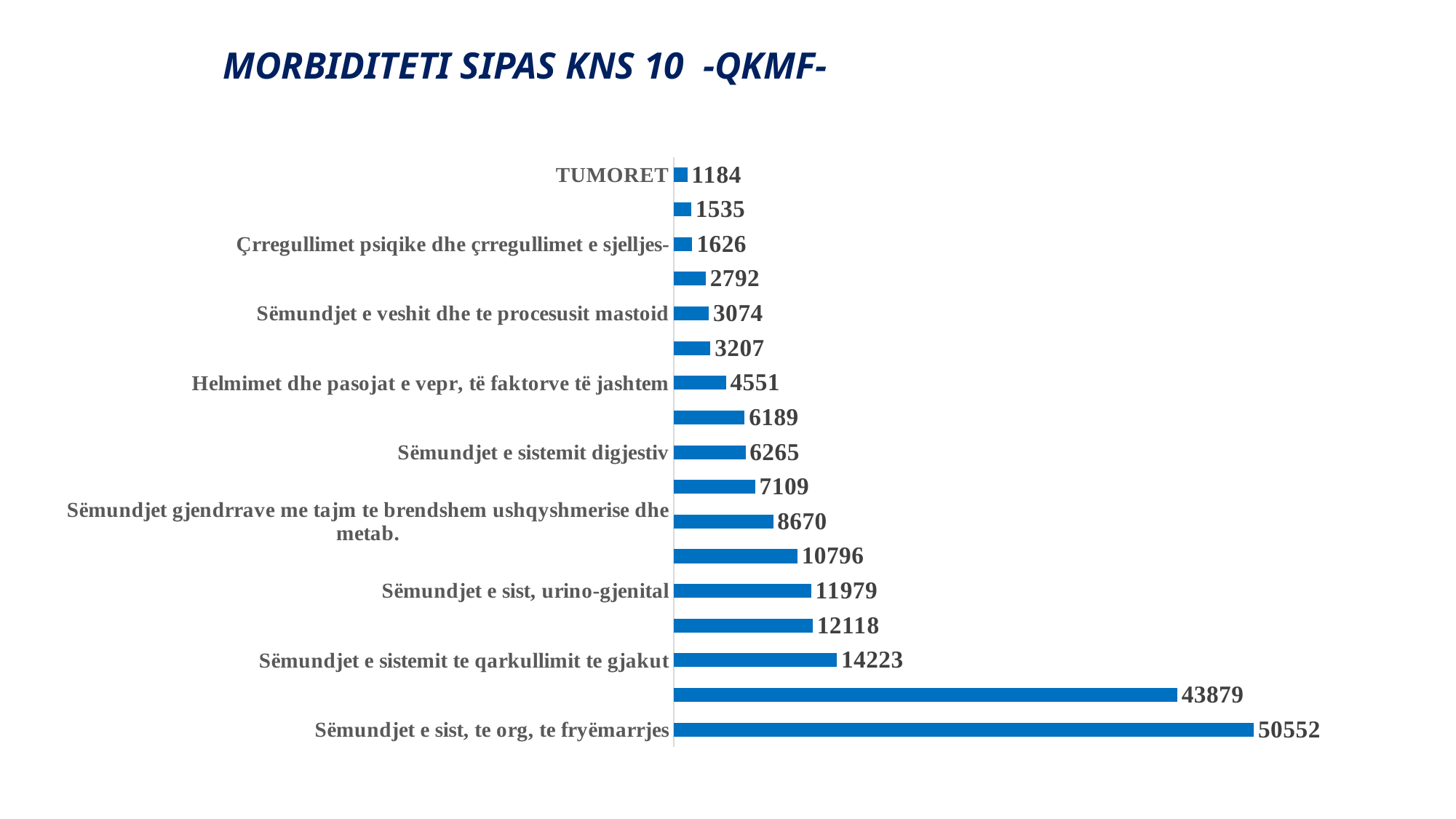
What is the value for TUMORET? 1184 Which category has the lowest value? TUMORET Which is larger: the value for Sëmundjet e sistemit digjestiv or the value for Sëmundjet e veshit dhe te procesusit mastoid? Sëmundjet e sistemit digjestiv What is the difference between the values for Sëmundjet e sist, te org, te fryëmarrjes and Sëmundjet e sistemit te qarkullimit te gjakut? 36329 What is the value for Sëmundjet e sist, te org, te fryëmarrjes? 50552 Which category has the highest value? Sëmundjet e sist, te org, te fryëmarrjes What is the value for Sëmundjet e sistemit te qarkullimit te gjakut? 14223 What type of chart is shown on the slide? Bar chart What is the value for Sëmundjet e sist, urino-gjenital? 11979 What is the value for Helmimet dhe pasojat e vepr, të faktorve të jashtem? 4551 How many bars are plotted in the chart? 17 What is the title of the chart? MORBIDITETI SIPAS KNS 10 -QKMF-